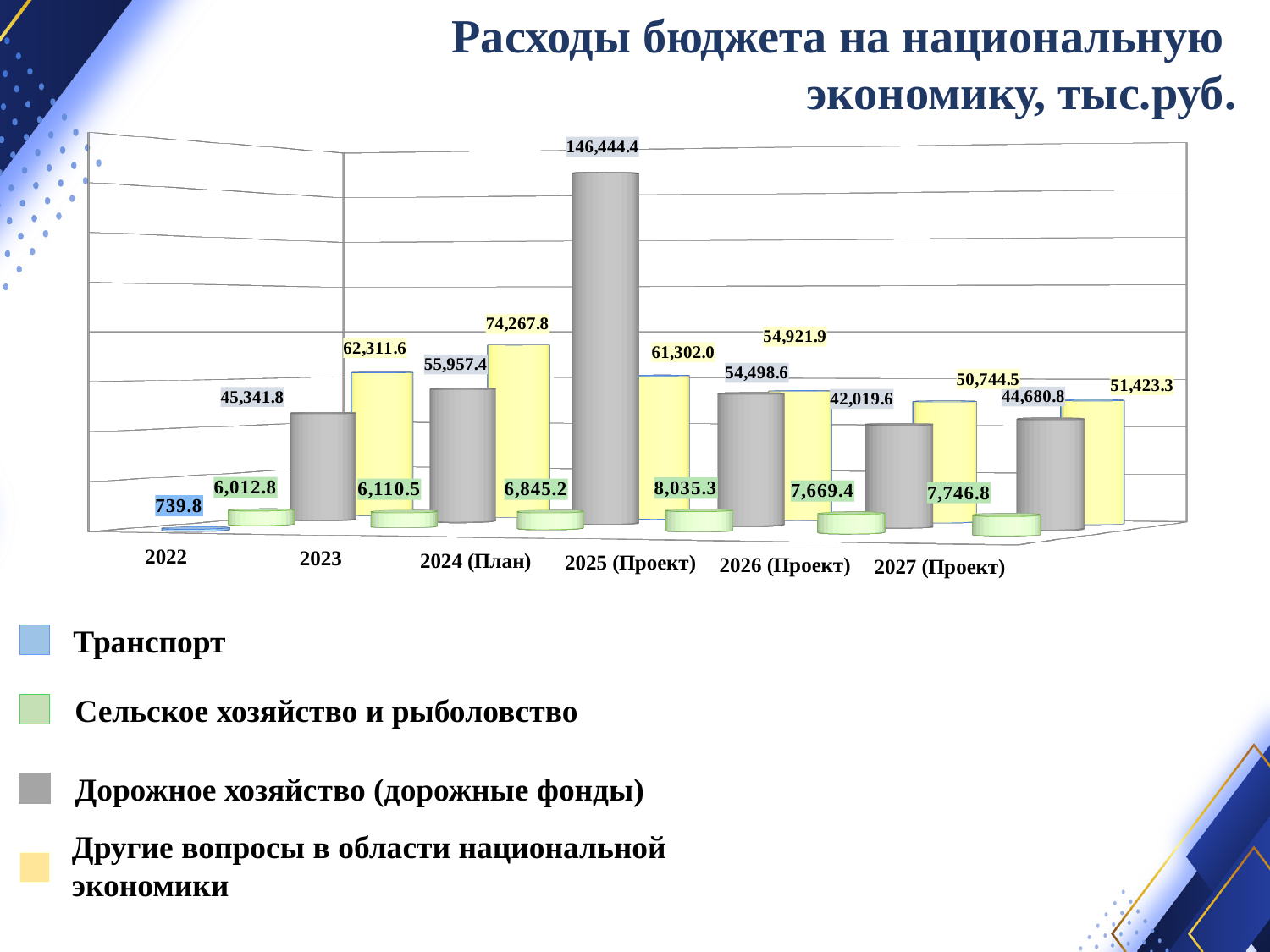
Which is larger in 2024 (План): Дорожное хозяйство (дорожные фонды) or Другие вопросы в области национальной экономики? Дорожное хозяйство (дорожные фонды) How many series does the legend list? 4 Which series has the highest value on the chart? Дорожное хозяйство (дорожные фонды) What is the value for Транспорт in 2022? 739.8 How many year categories are shown on the x axis? 6 What is the highest value shown anywhere on the chart? 146,444.4 In which year does Сельское хозяйство и рыболовство reach its highest value? 2025 (Проект) What is the value for Сельское хозяйство и рыболовство in 2025 (Проект)? 8,035.3 What is the difference between Другие вопросы в области национальной экономики (51,423.3) and Дорожное хозяйство (44,680.8) in 2027 (Проект)? 6,742.5 What kind of chart is shown on the slide? bar chart What colour represents Транспорт in the legend? blue What is the title of the chart? Расходы бюджета на национальную экономику, тыс.руб.